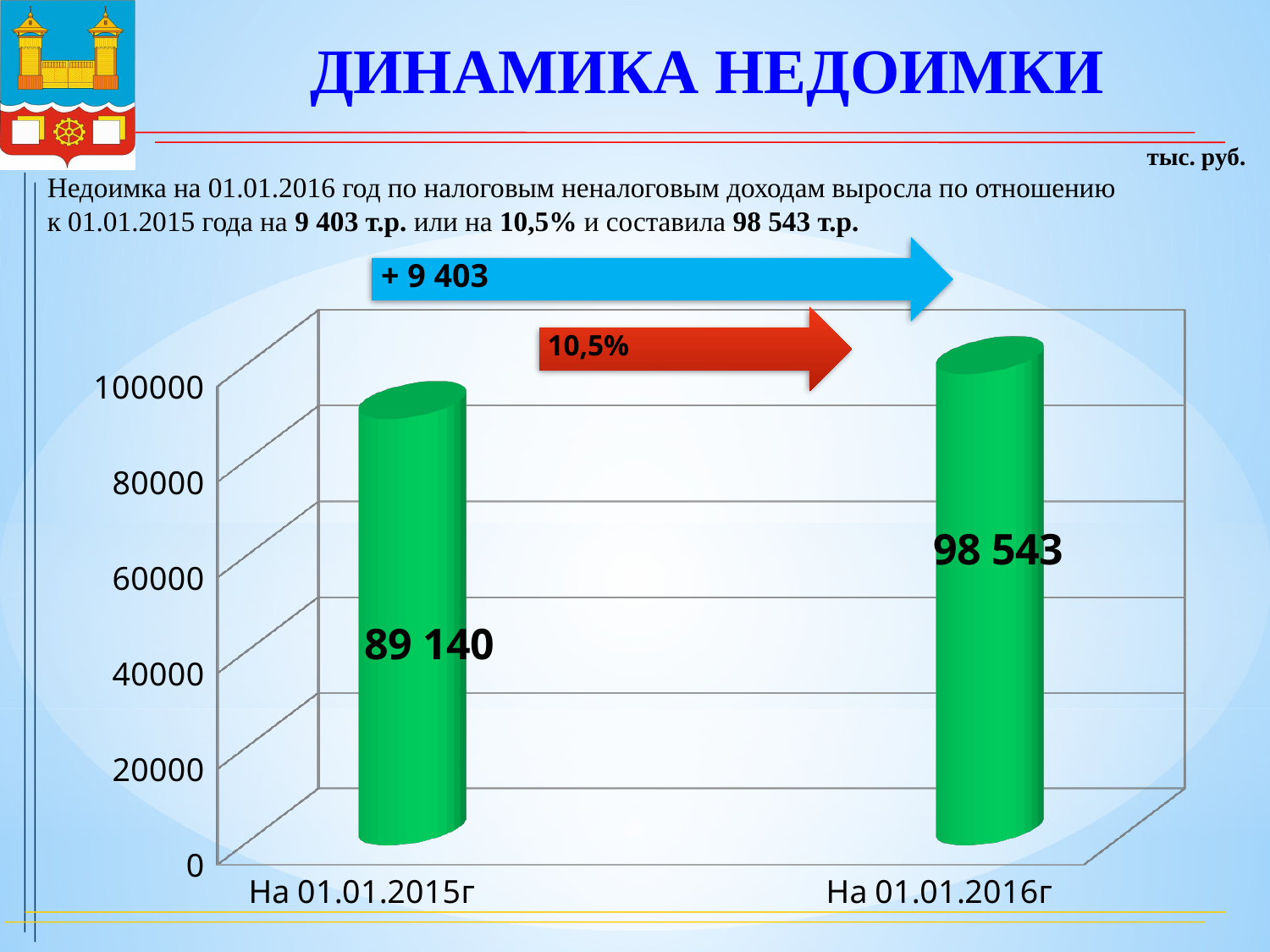
What kind of chart is shown on the slide? bar chart Do the values rise or fall from На 01.01.2015г to На 01.01.2016г? rise Which category has the highest value? На 01.01.2016г Which category has the lowest value? На 01.01.2015г What is the value for На 01.01.2015г? 89 140 Which is larger, the value for На 01.01.2015г or the value for На 01.01.2016г? На 01.01.2016г What is the difference between the values for На 01.01.2016г and На 01.01.2015г? 9 403 How many categories are shown on the x axis? 2 Is the value for На 01.01.2016г greater or less than 100000? less What is the title of the slide containing the chart? ДИНАМИКА НЕДОИМКИ Is the value for На 01.01.2015г greater or less than 80000? greater What is the value for На 01.01.2016г? 98 543